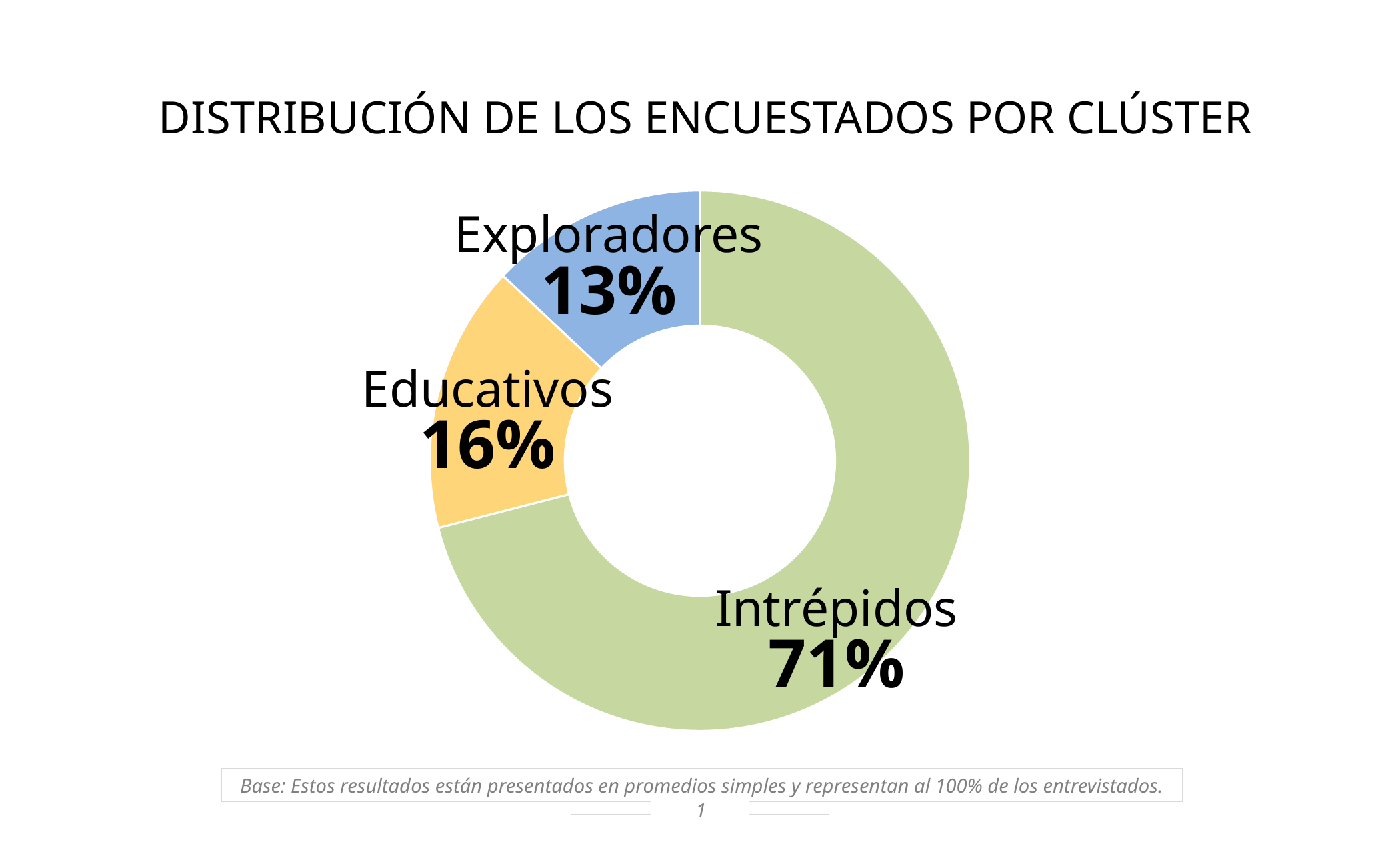
What percentage of respondents are in the Exploradores cluster? 13% Which cluster has the smallest share of respondents? Exploradores How many clusters are shown in the chart? 3 What is the difference in percentage points between the Educativos and Exploradores shares? 3 What kind of chart is shown on the slide? Doughnut (pie) chart Which cluster has a larger share, Educativos or Exploradores? Educativos What percentage of respondents are in the Educativos cluster? 16% What is the difference in percentage points between the Intrépidos and Educativos shares? 55 What is the title of the chart? DISTRIBUCIÓN DE LOS ENCUESTADOS POR CLÚSTER What colour is the Educativos segment? Yellow What percentage of respondents are in the Intrépidos cluster? 71% Which cluster has the largest share of respondents? Intrépidos